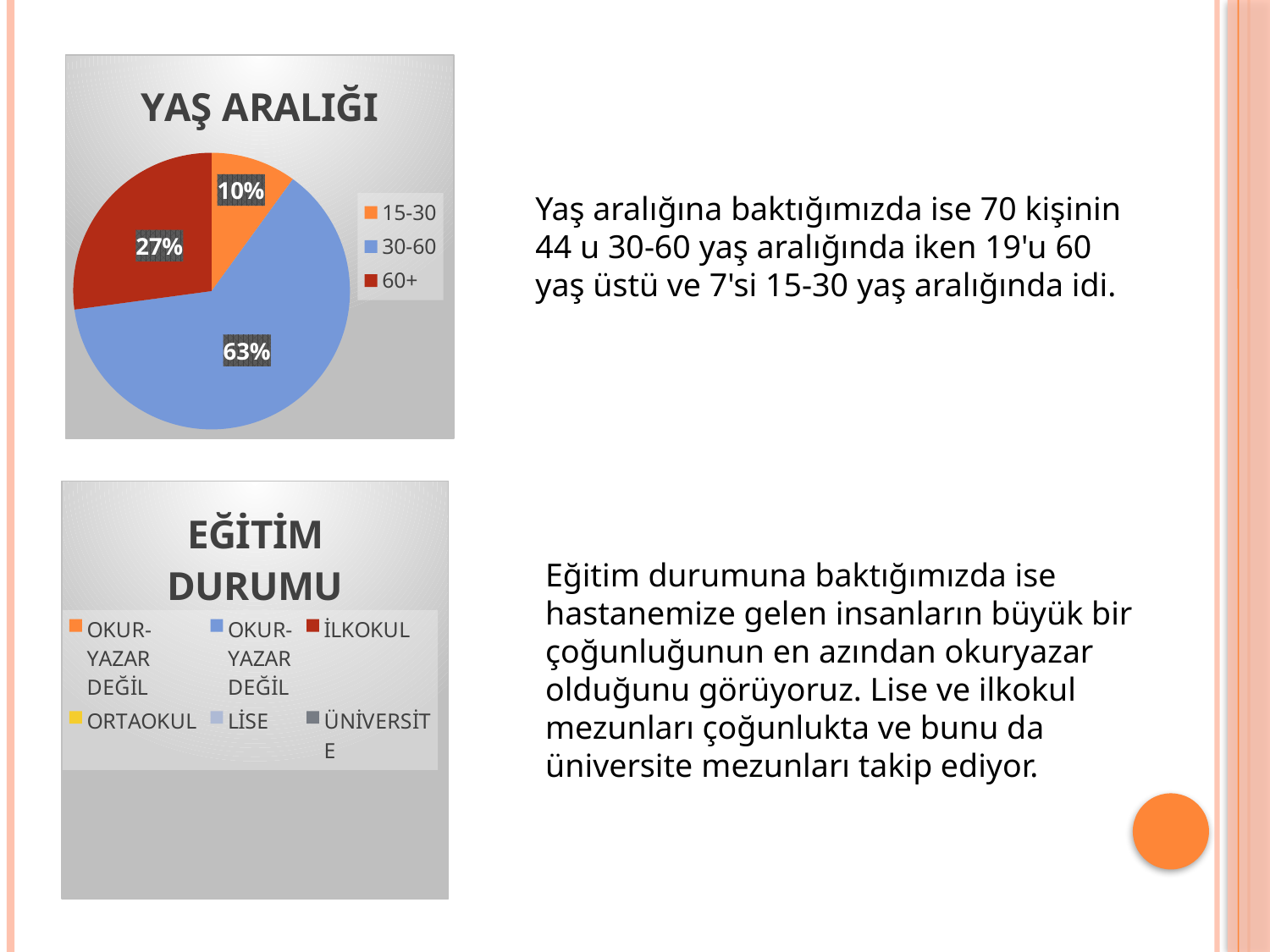
In the YAŞ ARALIĞI chart, which slice is larger, 60+ or 15-30? 60+ In the YAŞ ARALIĞI chart, what share of the pie does the 30-60 slice have? 63% In the YAŞ ARALIĞI chart, which age group has the smallest slice? 15-30 In the YAŞ ARALIĞI chart, which age group has the largest slice? 30-60 In the YAŞ ARALIĞI chart, what is the difference in percentage points between the 30-60 slice and the 60+ slice? 36% In the YAŞ ARALIĞI chart, what share of the pie does the 15-30 slice have? 10% In the YAŞ ARALIĞI chart, what colour is the 30-60 slice? Blue How many slices does the YAŞ ARALIĞI pie chart have? 3 What kind of chart is the YAŞ ARALIĞI chart? Pie chart In the YAŞ ARALIĞI chart, what is the difference in percentage points between the 60+ slice and the 15-30 slice? 17% In the YAŞ ARALIĞI chart, what share of the pie does the 60+ slice have? 27% How many entries does the legend of the EĞİTİM DURUMU chart list? 6